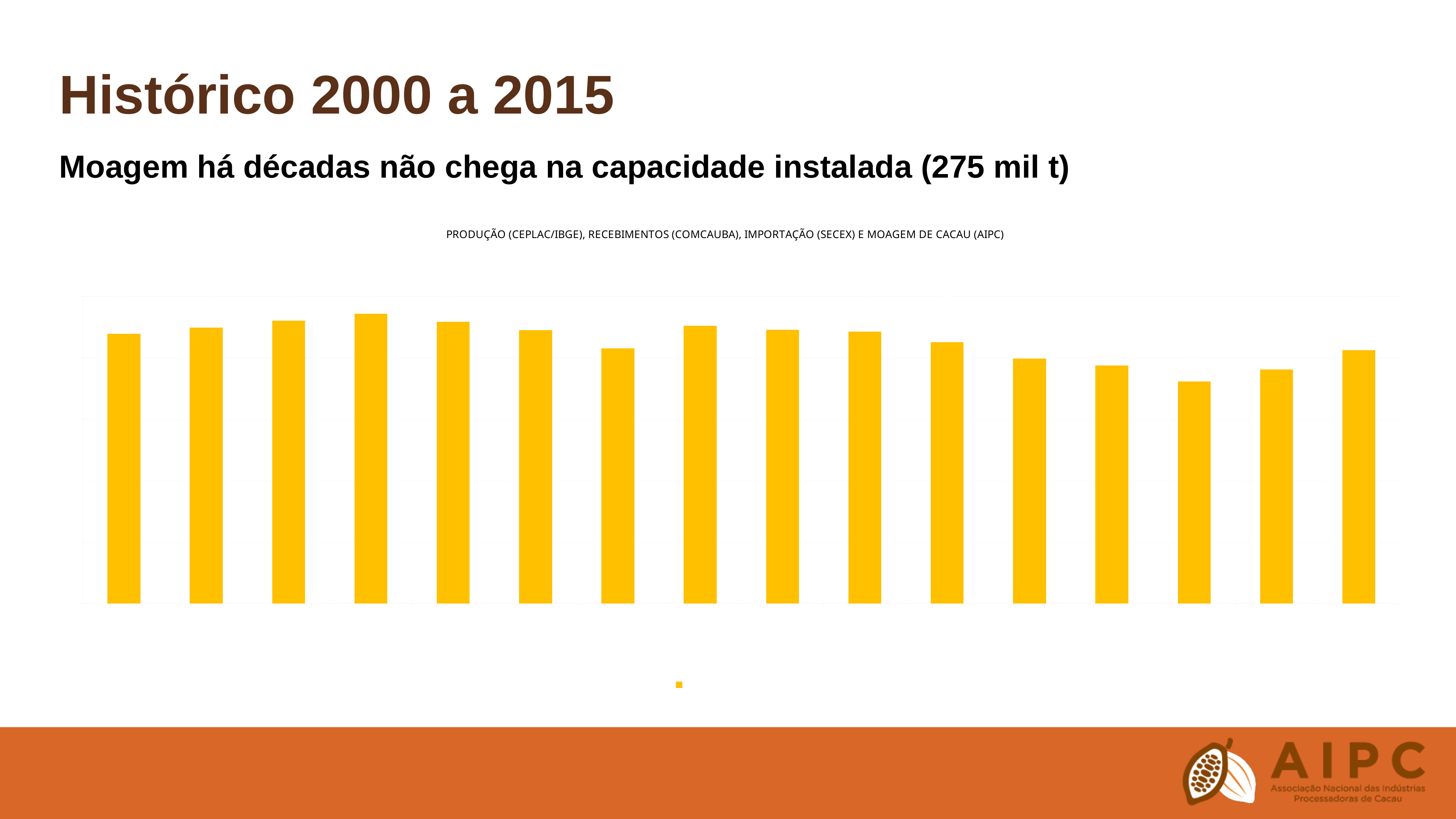
Which is taller, the fourth bar from the left or the fourteenth bar from the left? the fourth bar from the left Which is taller, the first bar on the left or the last bar on the right? the first bar on the left How many series does the legend show? 1 What is the title of the chart? PRODUÇÃO (CEPLAC/IBGE), RECEBIMENTOS (COMCAUBA), IMPORTAÇÃO (SECEX) E MOAGEM DE CACAU (AIPC) Counting from the left, which bar is the shortest in the chart? the fourteenth bar Which is taller, the seventh bar from the left or the eighth bar from the left? the eighth bar from the left Counting from the left, which bar is the tallest in the chart? the fourth bar What colour are the bars in the chart? yellow How many bars are plotted in the chart? 16 What kind of chart is shown on the slide? bar chart